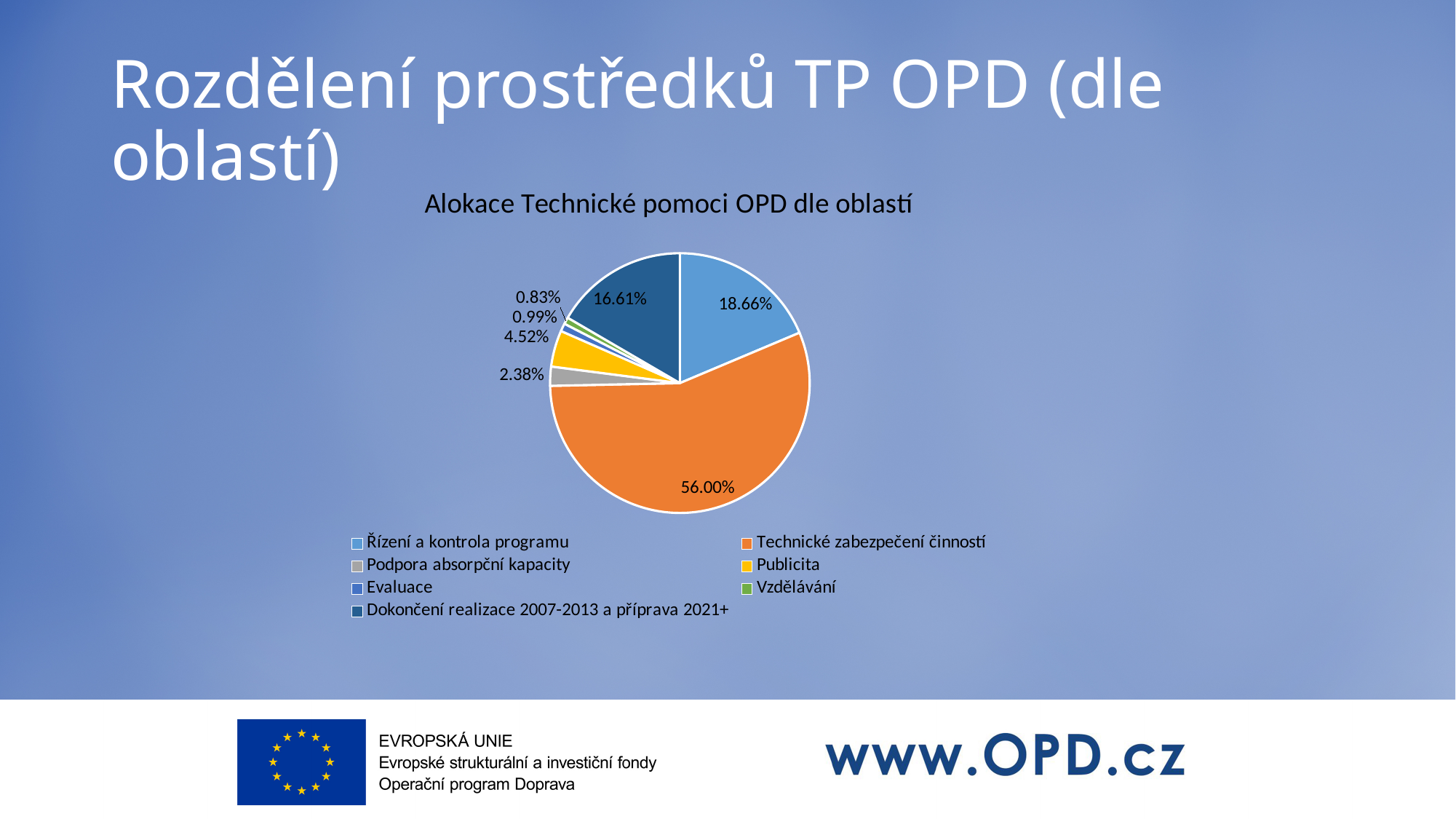
What share of the pie does Technické zabezpečení činností have? 56.00% Which category has the smallest slice of the pie? Vzdělávání What share of the pie does Dokončení realizace 2007-2013 a příprava 2021+ have? 16.61% Which category has the largest slice of the pie? Technické zabezpečení činností What is the value shown for Publicita? 4.52% What is the value shown for Vzdělávání? 0.83% What is the title of the chart? Alokace Technické pomoci OPD dle oblastí What share of the pie does Řízení a kontrola programu have? 18.66% What is the difference between the shares of Řízení a kontrola programu and Dokončení realizace 2007-2013 a příprava 2021+? 2.05% What is the value shown for Podpora absorpční kapacity? 2.38% How many categories does the pie chart have? 7 What type of chart is shown on the slide? pie chart